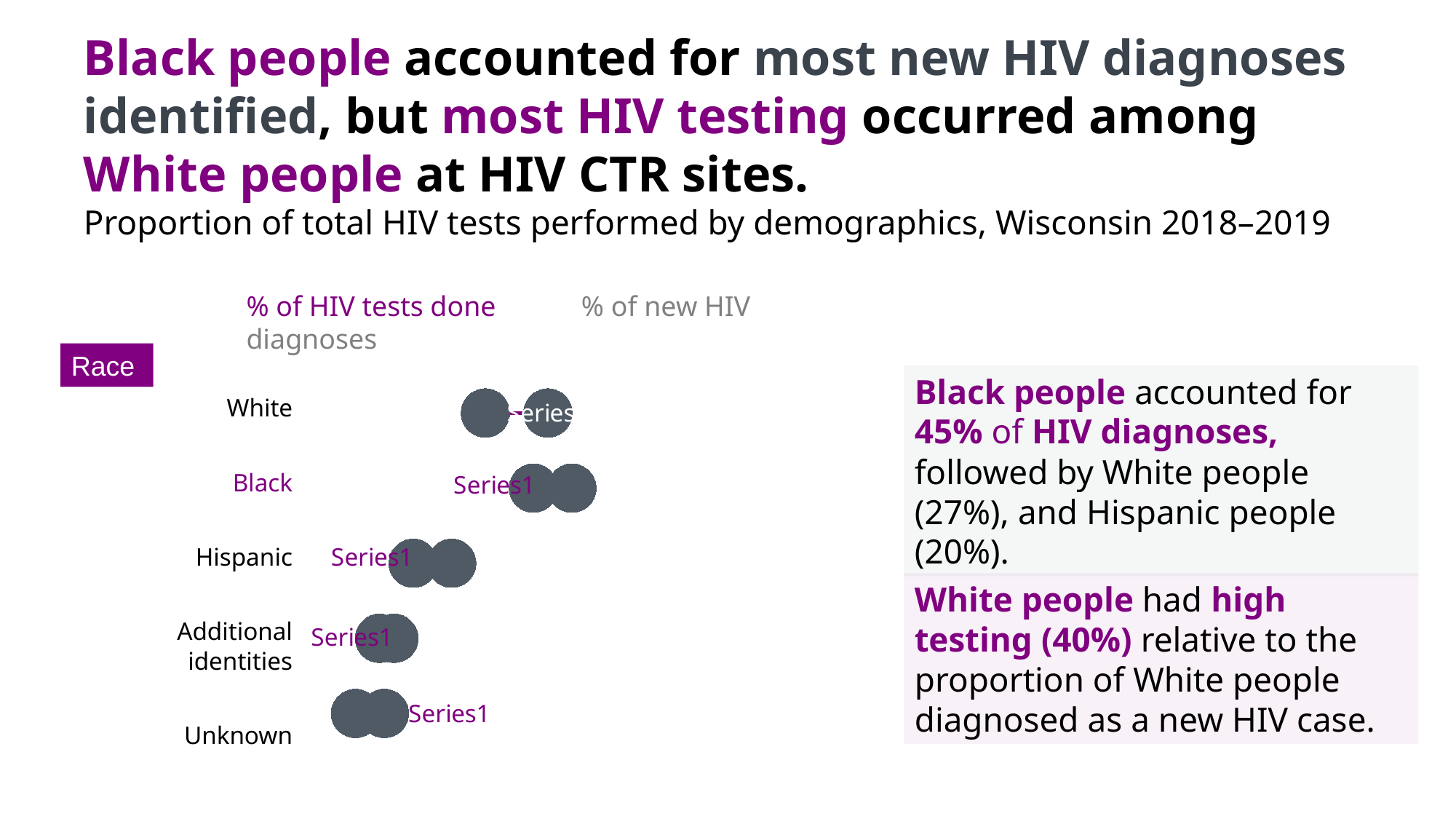
Which category is listed at the top of the chart? White How many series does the chart's legend list? 2 What is the subtitle describing the chart? Proportion of total HIV tests performed by demographics, Wisconsin 2018–2019 What label appears in the purple box above the category names? Race Which category is listed at the bottom of the chart? Unknown What kind of chart is shown on the slide? dot plot What are the two series named in the chart's legend? % of HIV tests done; % of new HIV diagnoses How many race categories are plotted on the chart? 5